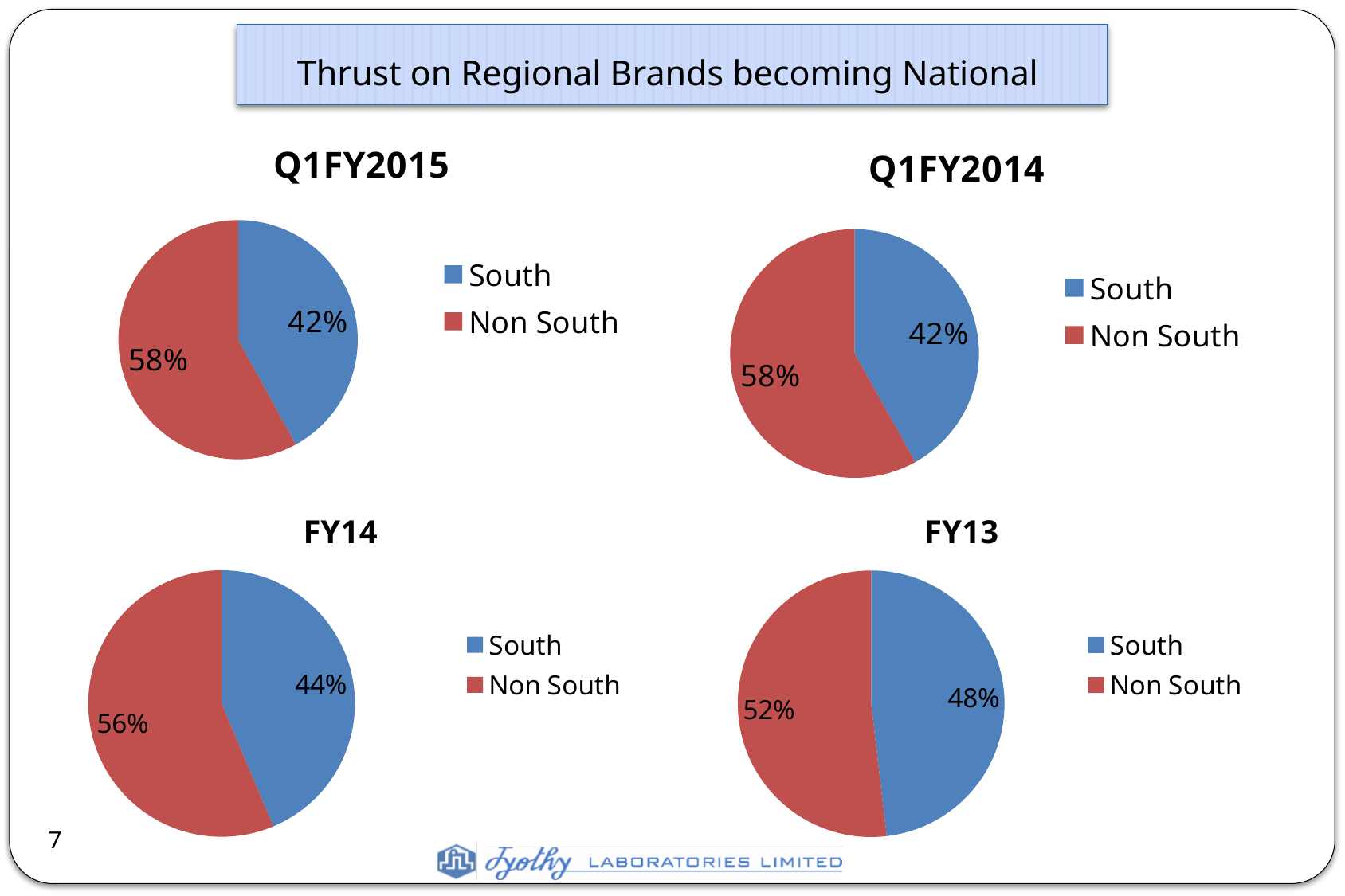
In the FY14 chart, which slice is the largest? Non South How many entries does the legend of the Q1FY2014 chart list? 2 In the FY13 chart, which slice is the smallest? South In the FY14 chart, what share does South have? 44% In the Q1FY2014 chart, what share does Non South have? 58% In the FY13 chart, what share does Non South have? 52% In the Q1FY2015 chart, what share does Non South have? 58% In the Q1FY2015 chart, which is larger, South or Non South? Non South What kind of chart is the FY13 chart? Pie chart In the FY13 chart, what share does South have? 48% In the FY14 chart, what is the difference between the Non South and South shares? 12% In the Q1FY2015 chart, what share does South have? 42%